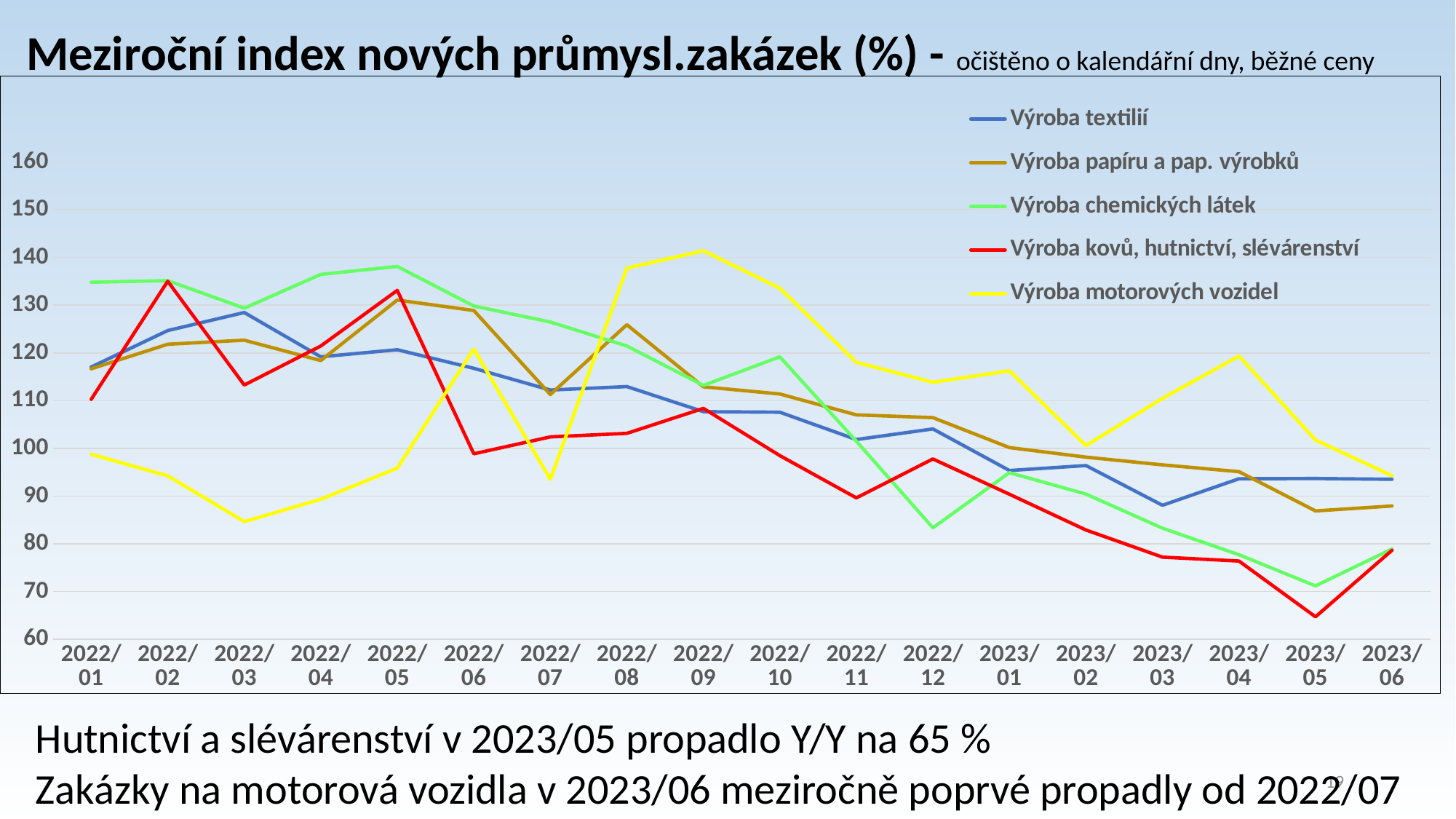
At 2022/06, which is larger: Výroba chemických látek or Výroba kovů, hutnictví, slévárenství? Výroba chemických látek What kind of chart is shown on the slide? line chart How many time points are shown on the x axis? 18 Is the value for Výroba motorových vozidel at 2022/09 greater or less than 130? greater What is the title of the chart? Meziroční index nových průmysl.zakázek (%) - očištěno o kalendářní dny, běžné ceny How many series does the legend list? 5 Is the value for Výroba kovů, hutnictví, slévárenství at 2023/05 greater or less than 70? less Is the value for Výroba chemických látek at 2022/05 greater or less than 130? greater Which series has the lowest value at 2023/05? Výroba kovů, hutnictví, slévárenství Which series has the highest value at 2022/09? Výroba motorových vozidel Does the value for Výroba kovů, hutnictví, slévárenství rise or fall from 2022/05 to 2023/05? fall Which series has the lowest value at 2022/03? Výroba motorových vozidel